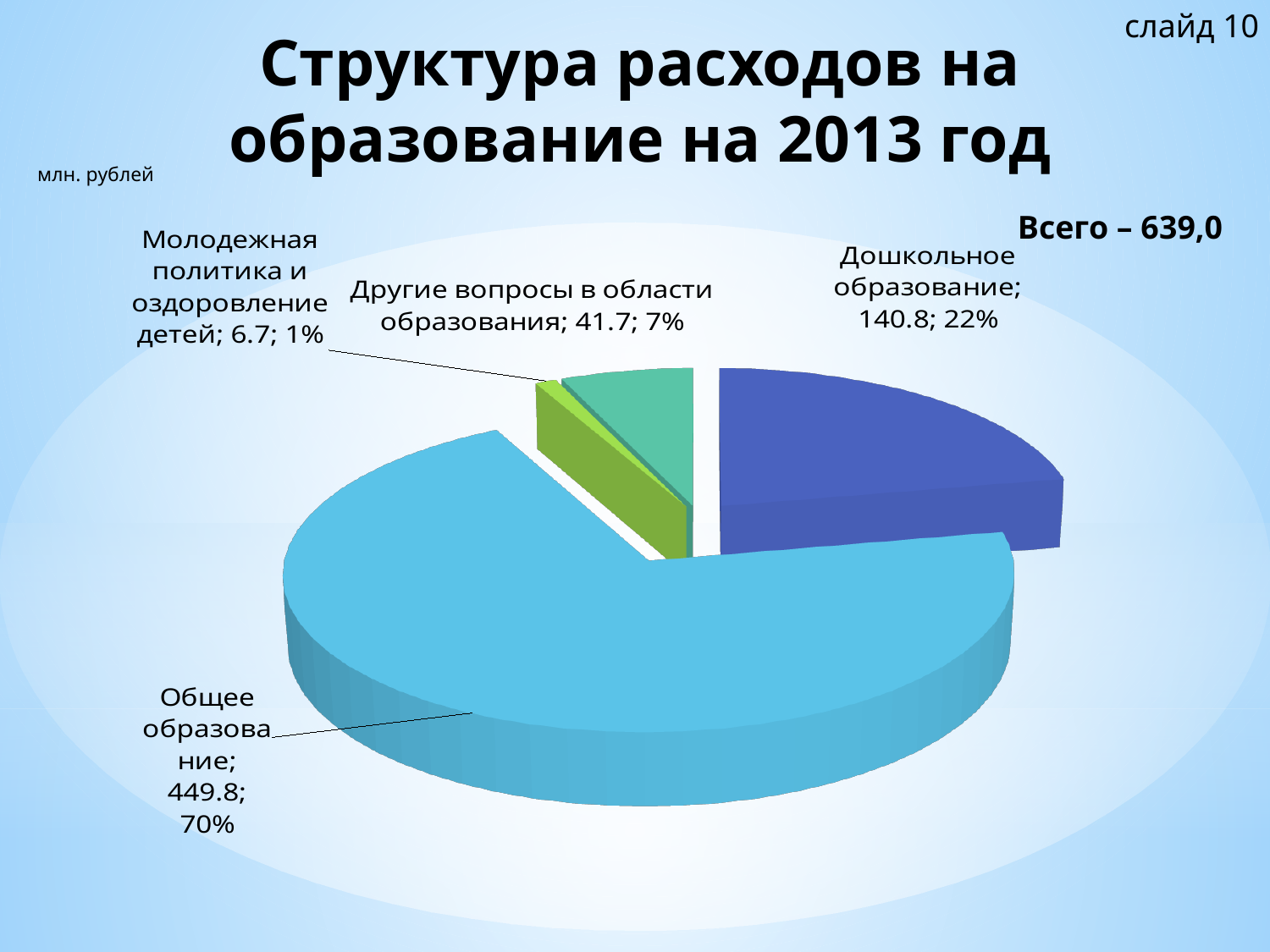
Which category has the smallest slice? Молодежная политика и оздоровление детей What kind of chart is shown on the slide? pie chart What share of the pie does Общее образование take? 70% Which category has the largest slice? Общее образование What is the value for Молодежная политика и оздоровление детей? 6.7 What is the value for Другие вопросы в области образования? 41.7 What share of the pie does Дошкольное образование take? 22% What is the value for Общее образование? 449.8 What is the value for Дошкольное образование? 140.8 How many slices does the pie chart have? 4 What is the difference between the values for Дошкольное образование and Другие вопросы в области образования? 99.1 What total is stated on the slide (Всего)? 639,0